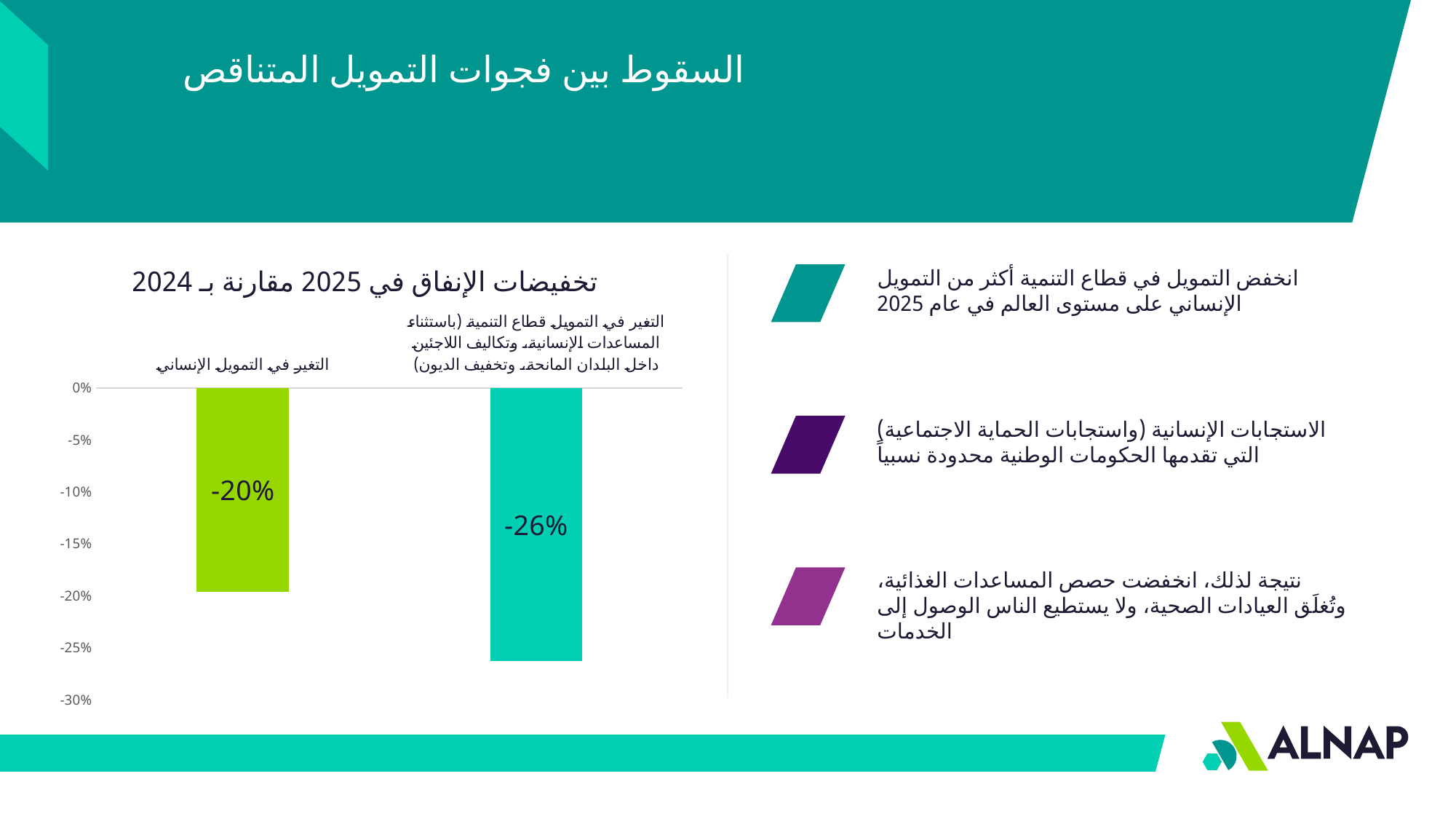
Is the decline for التغير في التمويل الإنساني larger or smaller than the decline for development sector funding? smaller What kind of chart is shown on the slide? bar chart What colour is the bar for التغير في التمويل الإنساني? green Which category shows the smaller decline? التغير في التمويل الإنساني How many bars are plotted in the chart? 2 What is the value shown for التغير في التمويل الإنساني? -20% Is the value for التغير في التمويل الإنساني greater or less than -15%? less What is the difference in percentage points between the two bars? 6 percentage points What is the title of the chart? تخفيضات الإنفاق في 2025 مقارنة بـ 2024 Is the value for development sector funding greater or less than -30%? greater Which category shows the larger decline? التغير في التمويل قطاع التنمية (باستثناء المساعدات الإنسانية، وتكاليف اللاجئين داخل البلدان المانحة، وتخفيف الديون) What is the value shown for التغير في التمويل قطاع التنمية (باستثناء المساعدات الإنسانية، وتكاليف اللاجئين داخل البلدان المانحة، وتخفيف الديون)? -26%